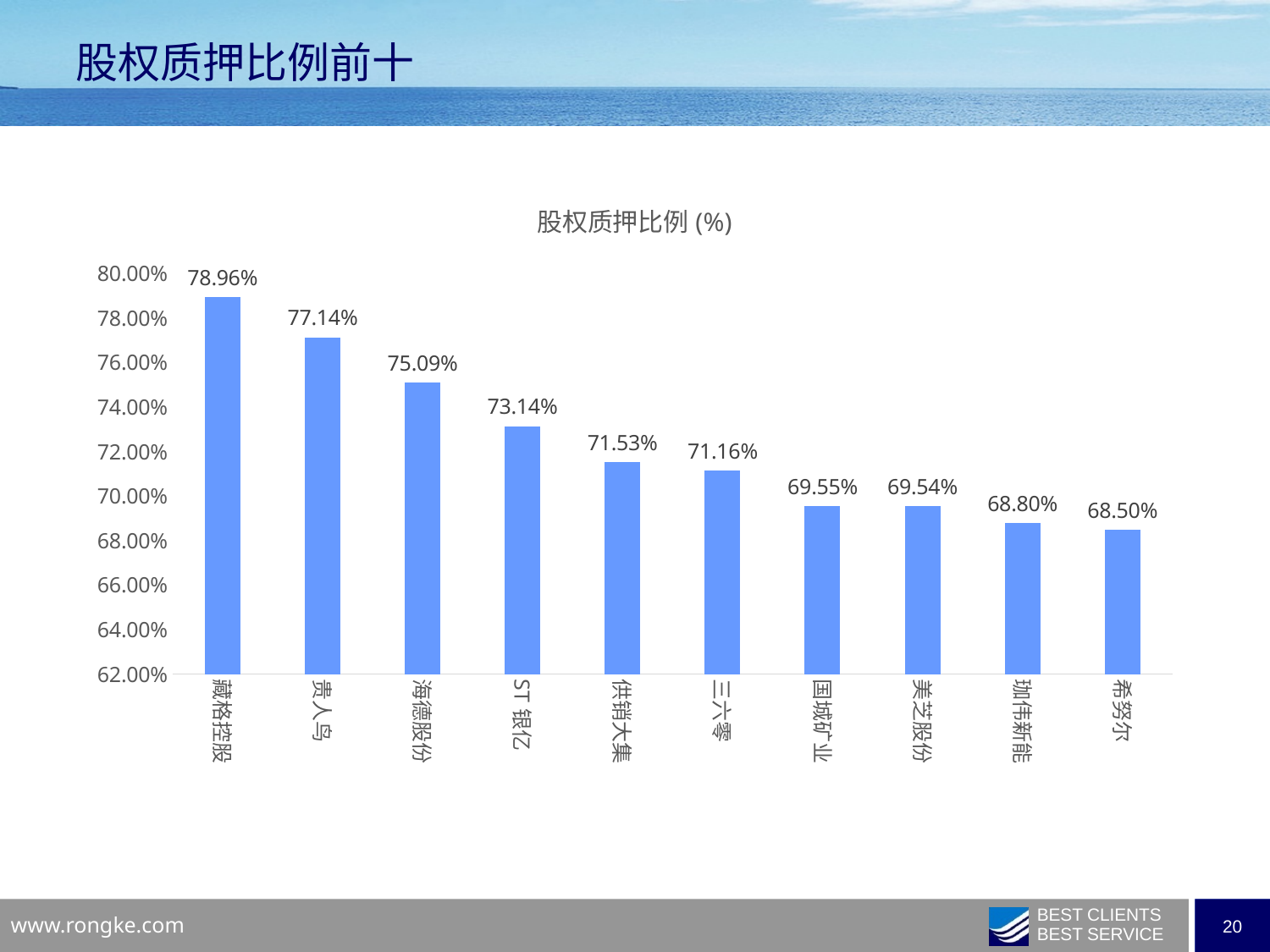
What is the title of the chart? 股权质押比例 (%) What is the difference between the values for 海德股份 and 珈伟新能? 6.29% Which category has the highest value? 藏格控股 What is the difference between the values for 藏格控股 and 贵人鸟? 1.82% How many categories are shown in the chart? 10 What is the value for 三六零? 71.16% What is the value for 希努尔? 68.50% What is the value for 藏格控股? 78.96% Which is larger, the value for ST 银亿 or the value for 供销大集? ST 银亿 Which category has the lowest value? 希努尔 What kind of chart is shown on the slide? bar chart Is the value for 国城矿业 greater or less than 70.00%? less